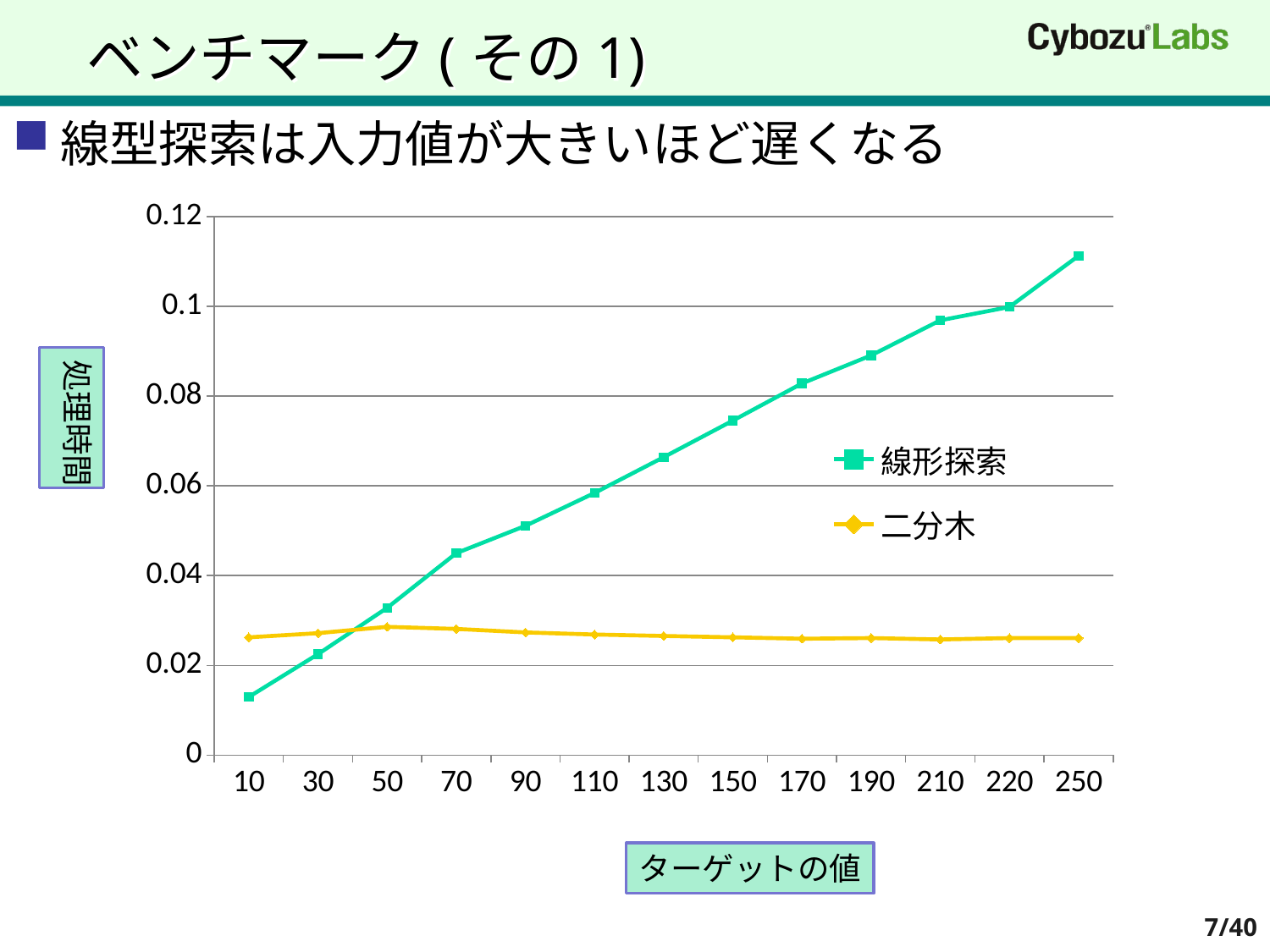
What is the label on the x axis of the chart? ターゲットの値 At which target value is the 線形探索 series highest? 250 Is the value for 二分木 at target value 250 greater or less than 0.04? less Is the value for 線形探索 at target value 250 greater or less than 0.1? greater How many target values are plotted along the x axis? 13 At target value 250, which series has the larger value, 線形探索 or 二分木? 線形探索 Is the value for 線形探索 at target value 130 greater or less than 0.06? greater At which target value is the 線形探索 series lowest? 10 Does the 線形探索 series rise or fall as the target value increases along the x axis? rise What kind of chart is shown on the slide? line chart At target value 10, which series has the larger value, 線形探索 or 二分木? 二分木 How many series does the legend list? 2